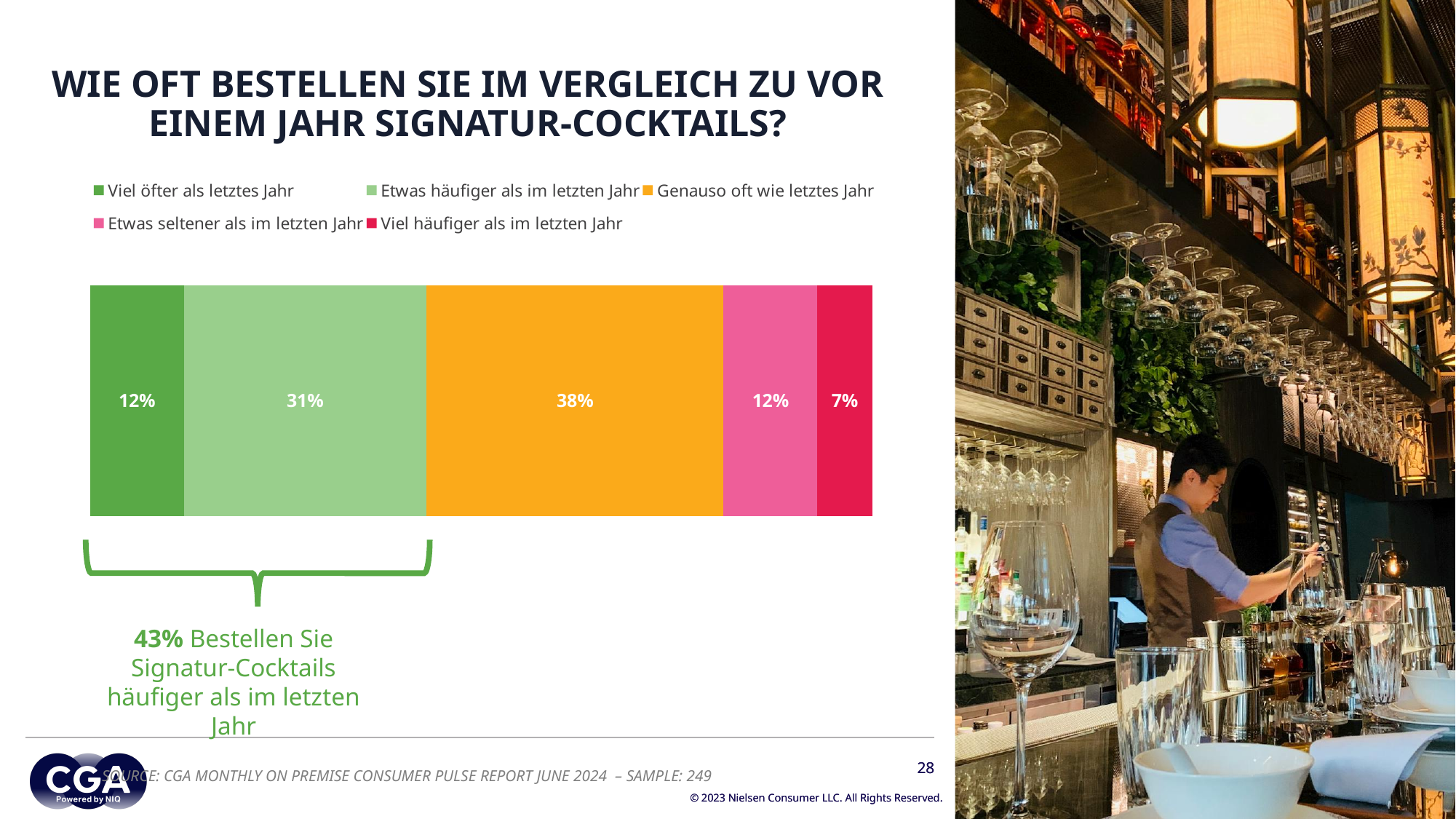
What percentage of respondents answered "Viel öfter als letztes Jahr"? 12% Which is larger: the share for "Etwas seltener als im letzten Jahr" or the share for the dark red segment? Etwas seltener als im letzten Jahr What percentage of respondents answered "Etwas häufiger als im letzten Jahr"? 31% What is the difference between the "Genauso oft wie letztes Jahr" share and the "Etwas häufiger als im letzten Jahr" share? 7 percentage points What is the value of the last (dark red) segment of the bar? 7% What percentage of respondents answered "Genauso oft wie letztes Jahr"? 38% According to the callout below the chart, what combined percentage order signature cocktails more often than last year? 43% How many segments does the stacked bar contain? 5 How many entries does the legend list? 5 What type of chart is shown on the slide? Stacked bar chart Which response category has the largest share? Genauso oft wie letztes Jahr Which response category has the smallest share? Viel häufiger als im letzten Jahr